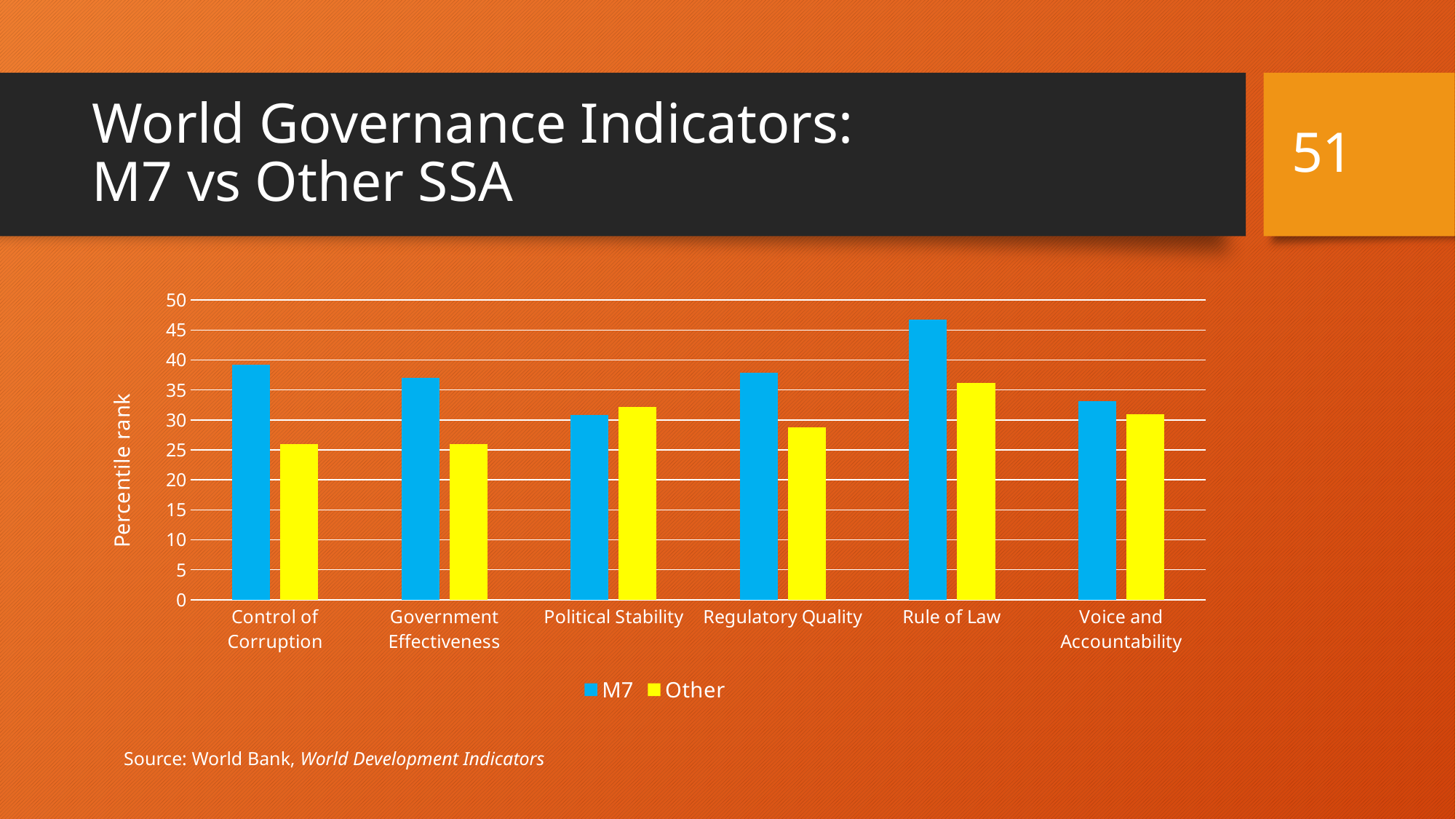
Is the Other value for Voice and Accountability greater or less than 35? less Which category has the highest M7 percentile rank? Rule of Law What kind of chart is shown on the slide? bar chart How many governance indicator categories are shown on the x axis? 6 Is the M7 value for Government Effectiveness greater or less than 35? greater Is the M7 value for Rule of Law greater or less than 45? greater For Control of Corruption, which is larger, the M7 value or the Other value? M7 For Regulatory Quality, which is larger, the M7 value or the Other value? M7 Which category has the highest Other percentile rank? Rule of Law How many series does the legend list? 2 What is the label of the y axis? Percentile rank